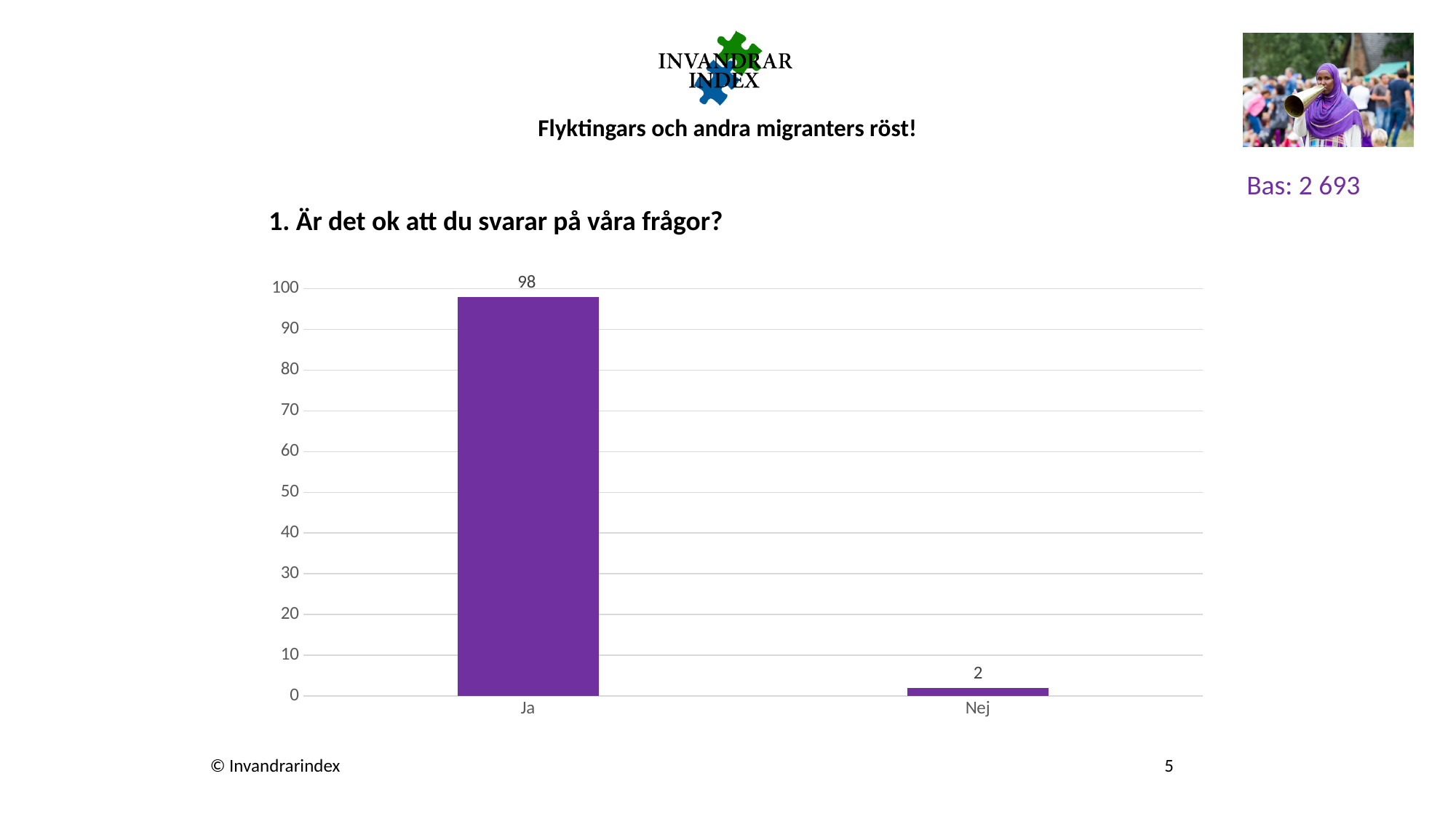
Is the value for Nej greater or less than 10? less How many categories are shown on the x axis? 2 Which category has the lowest value? Nej Which category has the highest value? Ja What is the title of the chart? 1. Är det ok att du svarar på våra frågor? What kind of chart is shown on the slide? bar chart What is the maximum value shown on the y axis? 100 What is the value for Nej? 2 What is the difference between the values for Ja and Nej? 96 Which is larger, the value for Ja or the value for Nej? Ja Is the value for Ja greater or less than 90? greater What is the value for Ja? 98